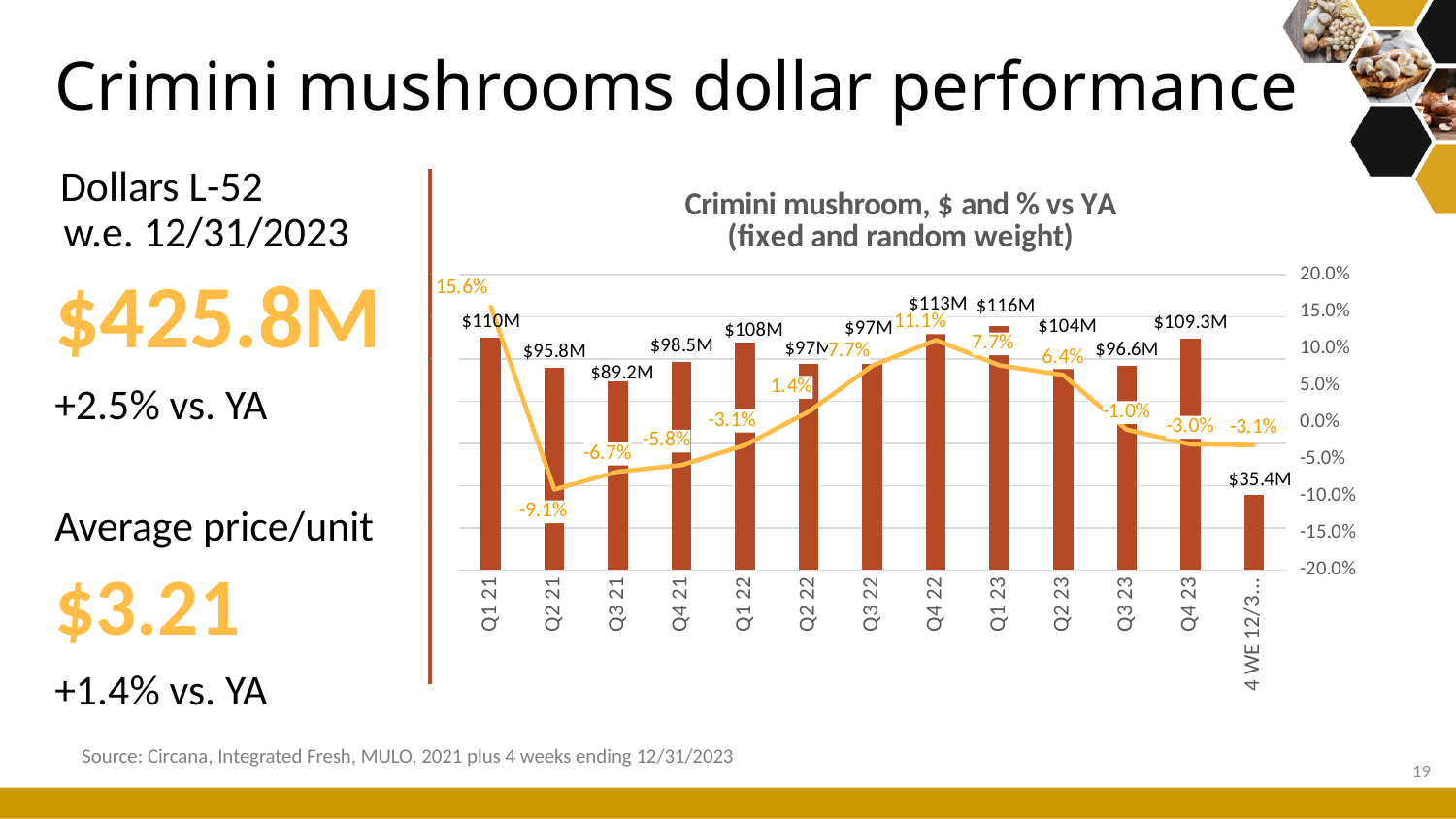
How many periods are shown on the x axis? 13 What is the dollar value shown for Q3 21? $89.2M Which period has the highest % vs YA value? Q1 21 Which period has the lowest % vs YA value? Q2 21 What is the dollar value shown for the final period, 4 WE 12/3...? $35.4M What is the difference in dollar value between Q1 23 and Q2 23? $12M What is the % vs YA value shown for Q4 22? 11.1% What is the % vs YA value shown for Q2 21? -9.1% Which has the larger dollar value, Q4 22 or Q4 23? Q4 22 What is the dollar value shown for Q1 23? $116M What kind of chart is shown? Combined bar and line chart Which quarter has the highest dollar value? Q1 23